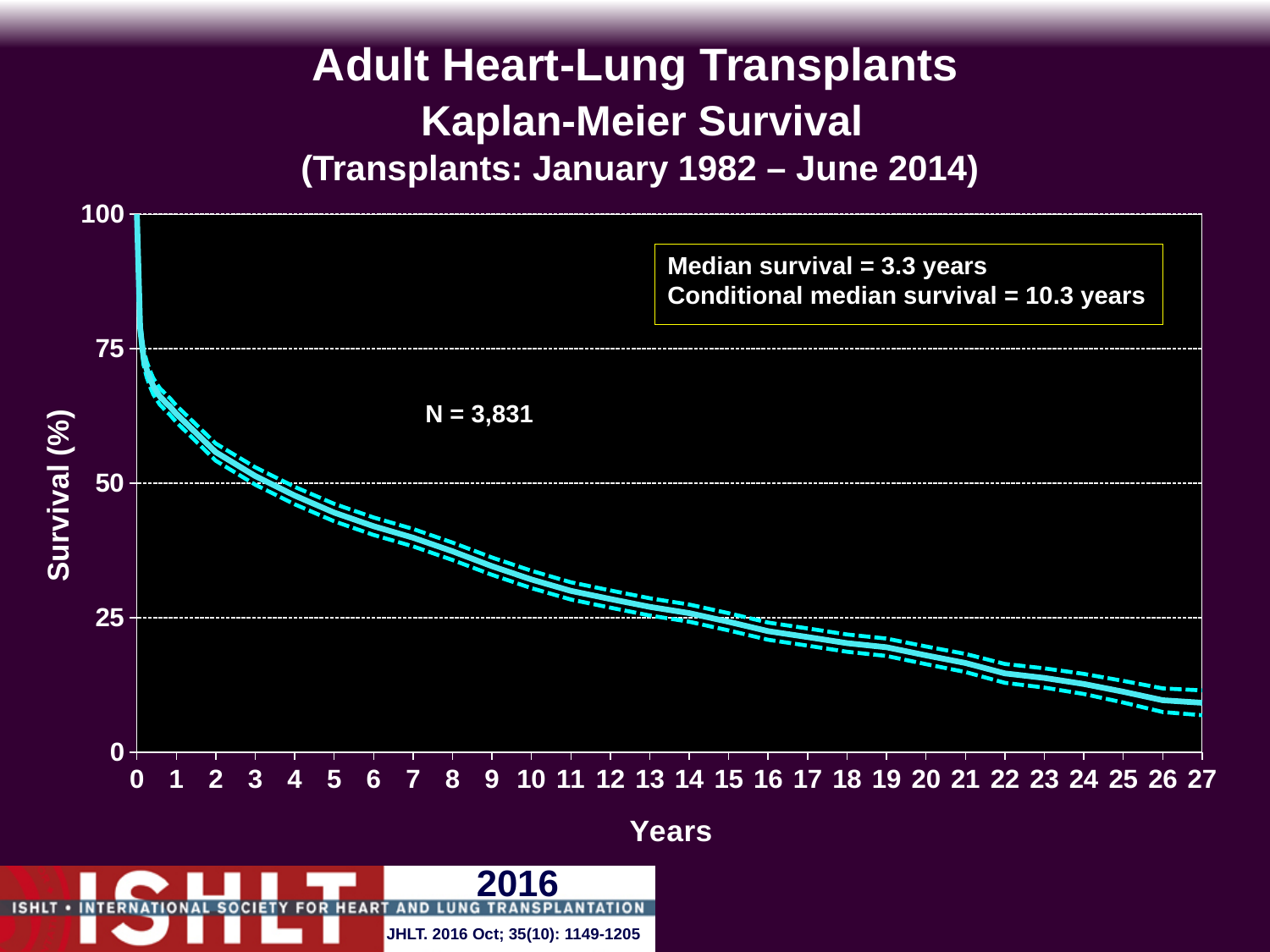
What is the median survival stated on the chart? 3.3 years Is the survival value at 20 years greater or less than 25? less What kind of chart is shown on the slide? line chart What is the value of N shown on the chart? 3,831 What is the highest value shown on the x axis? 27 Does the survival curve rise or fall as the number of years increases? fall Is the survival value at 10 years greater or less than 25? greater What is the label of the y axis? Survival (%) Is the survival value at 5 years greater or less than 50? less What is the conditional median survival stated on the chart? 10.3 years